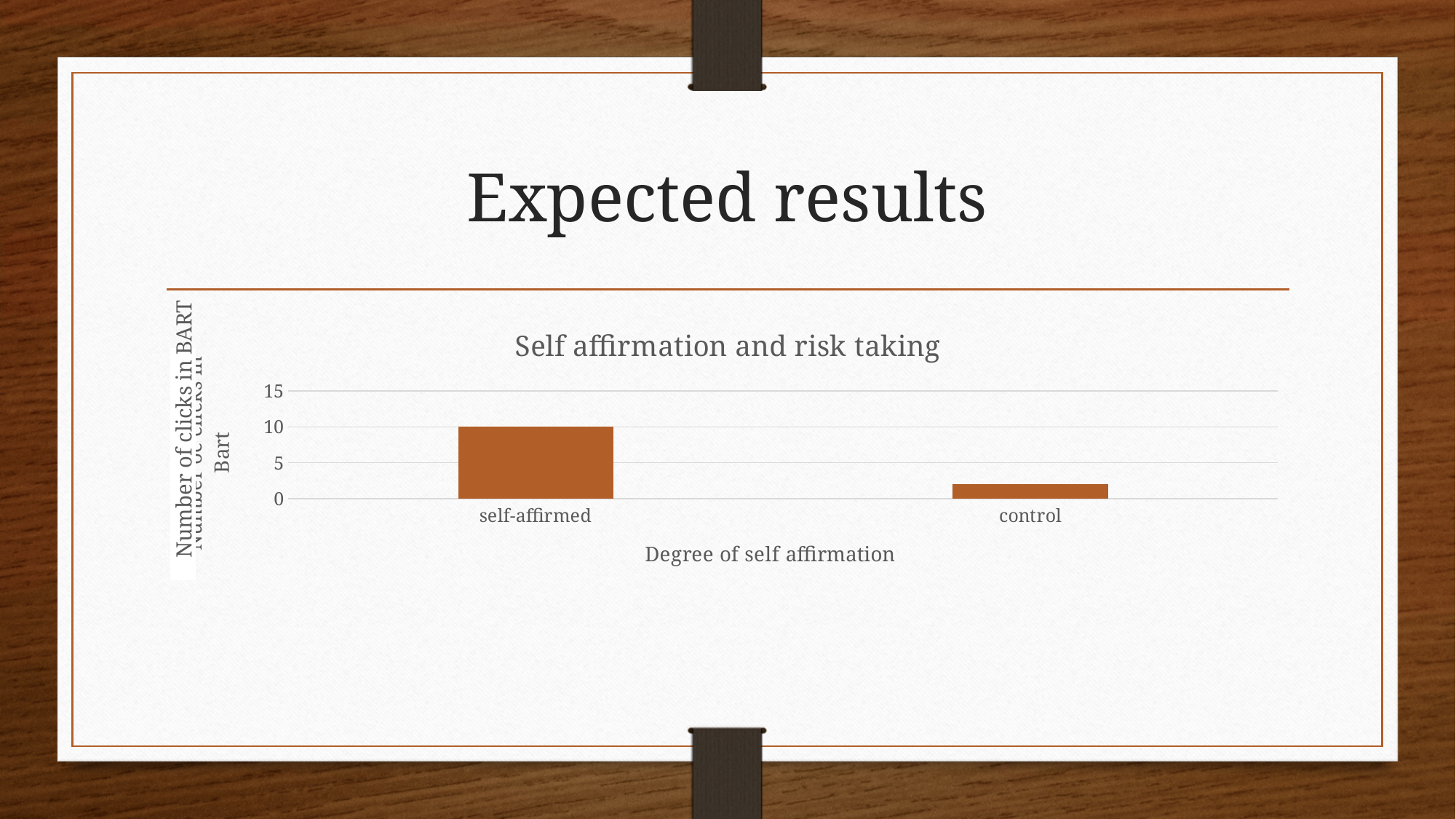
What is the title of the x axis of the chart? Degree of self affirmation How many categories are plotted on the x axis of the chart? 2 Which category has the highest value in the chart? self-affirmed What is the value for self-affirmed in the chart? 10 Do the values rise or fall from left to right along the x axis? fall What kind of chart is shown on the slide? bar chart Is the value for control greater or less than 5? less Is the value for control greater or less than 10? less What is the title of the chart? Self affirmation and risk taking Which category has the lowest value in the chart? control Which has the larger value, self-affirmed or control? self-affirmed Is the value for self-affirmed greater or less than 5? greater